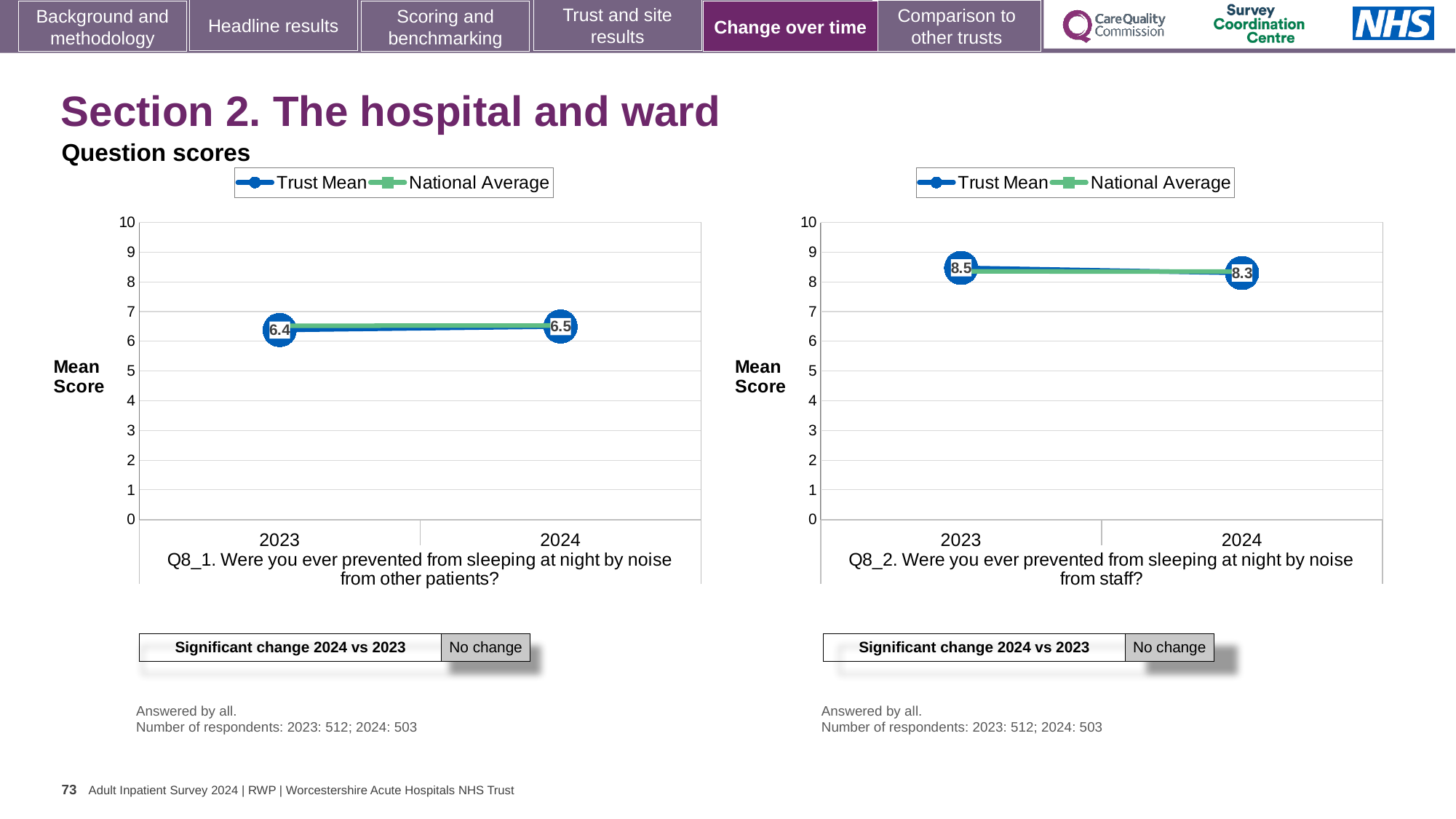
On the right chart (Q8_2, noise from staff), what is the Trust Mean score for 2024? 8.3 On the right chart (Q8_2, noise from staff), does the Trust Mean rise or fall from 2023 to 2024? fall On the left chart (Q8_1, noise from other patients), what is the Trust Mean score for 2024? 6.5 What kind of chart is the left chart (Q8_1, noise from other patients)? line chart On the right chart (Q8_2, noise from staff), which year has the higher Trust Mean score, 2023 or 2024? 2023 How many years are plotted on the x axis of the right chart (Q8_2)? 2 On the right chart (Q8_2, noise from staff), what is the Trust Mean score for 2023? 8.5 How many series does the legend of the left chart (Q8_1) list? 2 On the left chart (Q8_1, noise from other patients), is the Trust Mean score for 2024 greater or less than 7? less On the left chart (Q8_1, noise from other patients), does the Trust Mean rise or fall from 2023 to 2024? rise On the left chart (Q8_1, noise from other patients), what is the Trust Mean score for 2023? 6.4 On the right chart (Q8_2, noise from staff), what is the difference between the Trust Mean scores for 2023 and 2024? 0.2